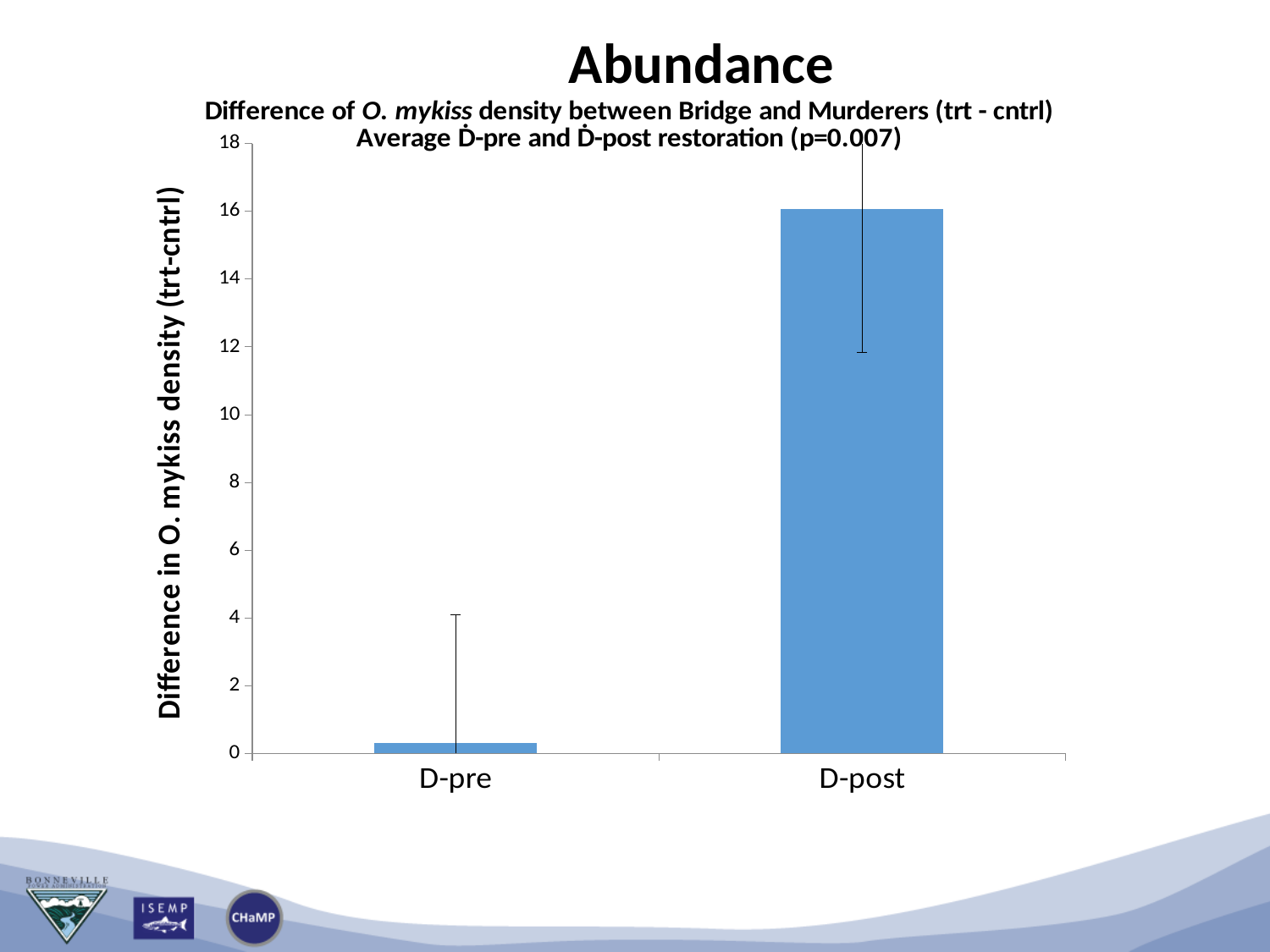
Do the values rise or fall from D-pre to D-post? rise What kind of chart is shown on the slide? bar chart What p-value is stated in the chart title? p=0.007 Is the value for D-post greater or less than 10? greater How many categories are plotted on the x axis? 2 Which category has the higher value, D-pre or D-post? D-post What is the label of the y axis? Difference in O. mykiss density (trt-cntrl) Is the value for D-post greater or less than 14? greater Is the value for D-post larger than the value for D-pre? yes Which category has the lowest value? D-pre Is the value for D-pre greater or less than 2? less